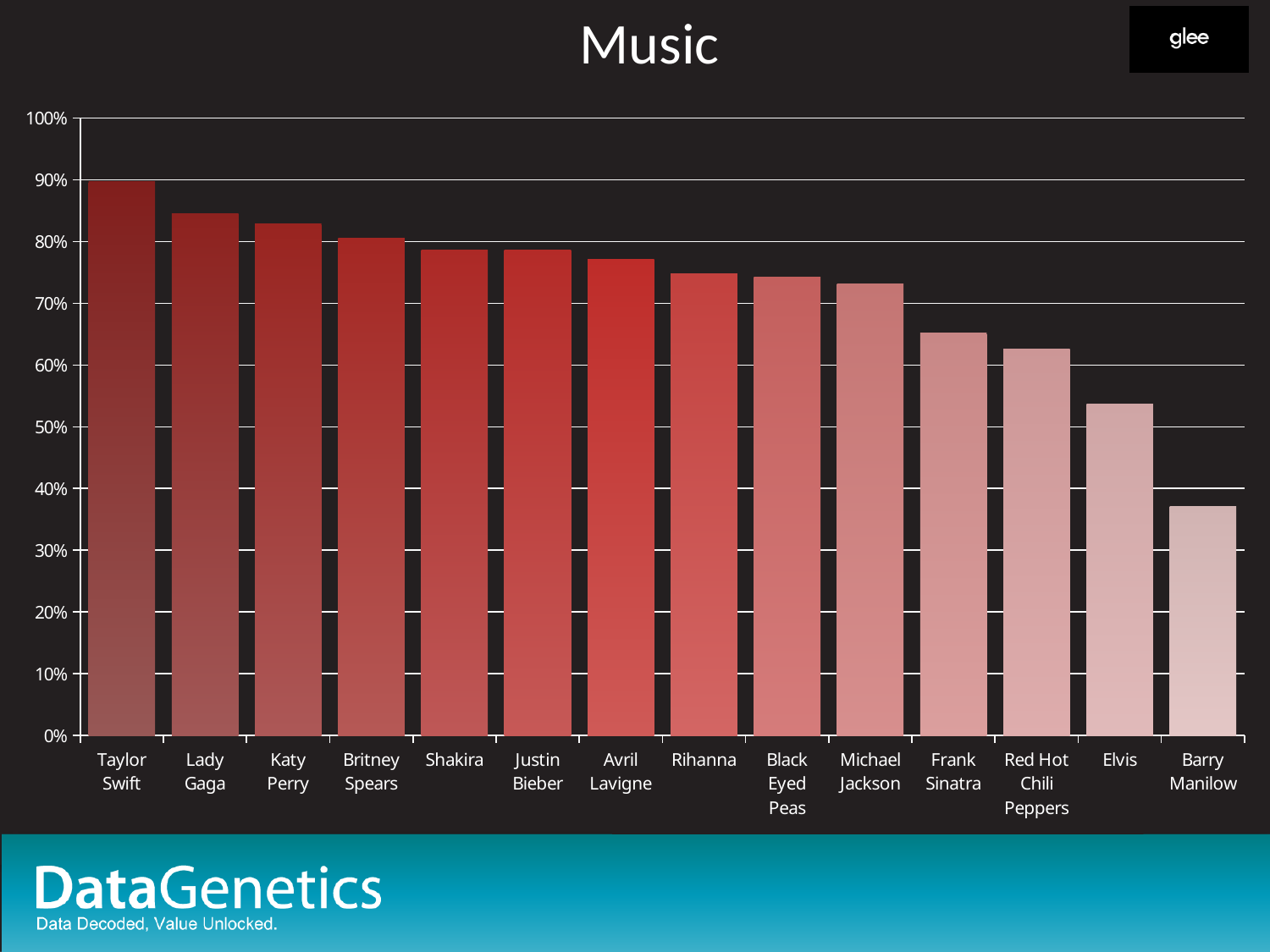
Which has a larger value, Lady Gaga or Rihanna? Lady Gaga Which artist has the highest value in the chart? Taylor Swift How many artists are shown on the x axis of the chart? 14 What is the title of the chart? Music Is the value for Michael Jackson greater or less than 70%? greater What type of chart is shown on the slide? bar chart Is the value for Taylor Swift greater or less than 80%? greater Do the values rise or fall moving from left to right along the x axis? fall Is the value for Elvis greater or less than 50%? greater Which artist has the lowest value in the chart? Barry Manilow